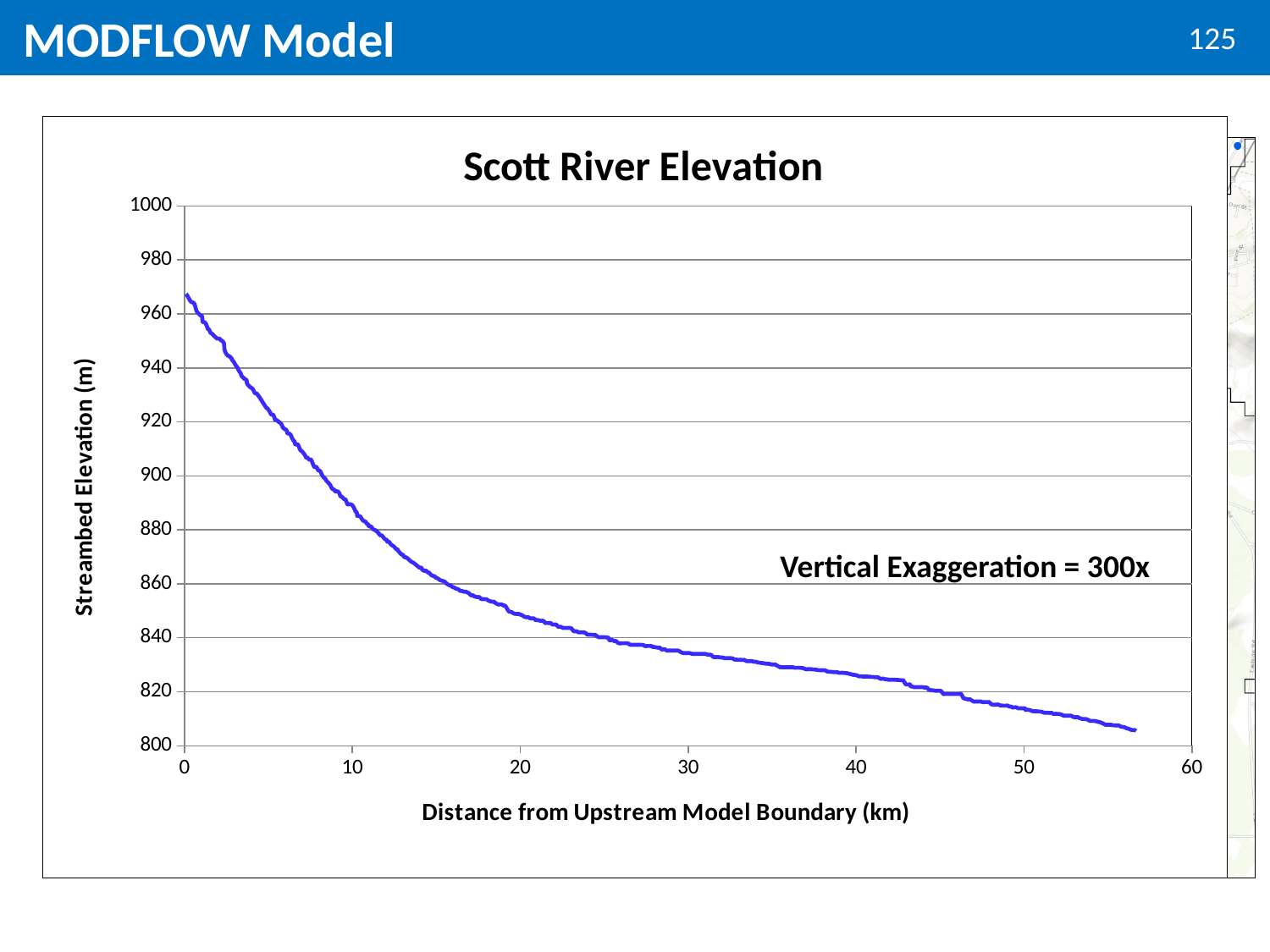
Is the streambed elevation higher at 10 km or at 40 km? 10 km Is the streambed elevation at 30 km greater or less than 840? less What is the label of the x axis? Distance from Upstream Model Boundary (km) Is the streambed elevation at 40 km greater or less than 820? greater Does the streambed elevation rise or fall as distance from the upstream model boundary increases? fall Is the streambed elevation at 0 km greater or less than 960? greater At which distance along the x axis is the streambed elevation highest? 0 km What kind of chart is shown on the slide? line chart What is the title of the chart? Scott River Elevation